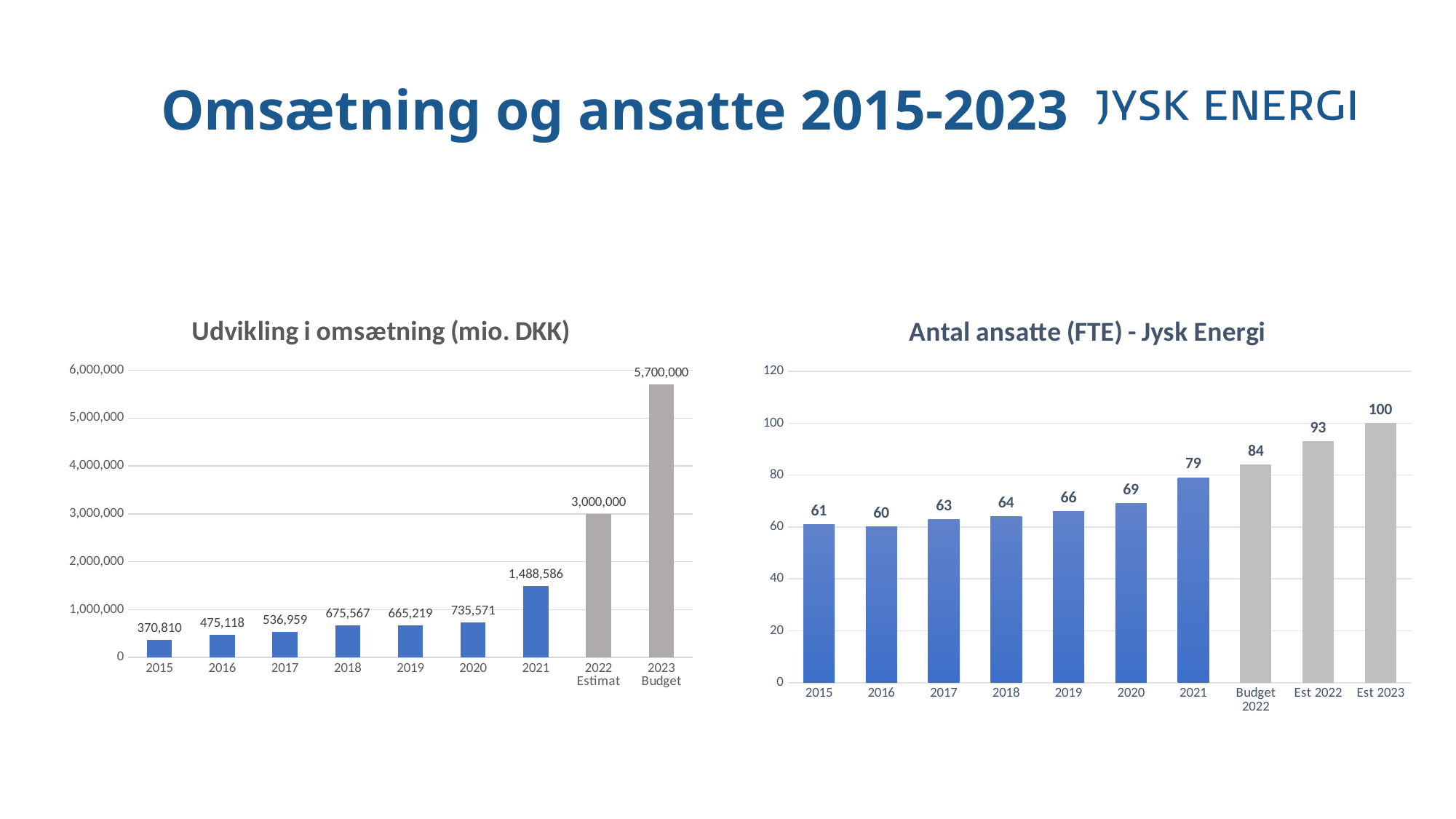
In the 'Antal ansatte (FTE) - Jysk Energi' chart, what is the value for 2019? 66 In the 'Udvikling i omsætning (mio. DKK)' chart, how many categories are shown on the x axis? 9 In the 'Antal ansatte (FTE) - Jysk Energi' chart, how many categories are shown on the x axis? 10 In the 'Udvikling i omsætning (mio. DKK)' chart, which category has the lowest value? 2015 What kind of chart is the 'Antal ansatte (FTE) - Jysk Energi' chart? Bar chart In the 'Udvikling i omsætning (mio. DKK)' chart, what is the value for 2023 Budget? 5,700,000 In the 'Antal ansatte (FTE) - Jysk Energi' chart, what is the difference between Est 2022 and Budget 2022? 9 In the 'Udvikling i omsætning (mio. DKK)' chart, what is the value for 2017? 536,959 In the 'Udvikling i omsætning (mio. DKK)' chart, which is larger, the value for 2018 or the value for 2019? 2018 In the 'Udvikling i omsætning (mio. DKK)' chart, what is the difference between the 2021 value and the 2020 value? 753,015 In the 'Antal ansatte (FTE) - Jysk Energi' chart, which category has the lowest value? 2016 In the 'Antal ansatte (FTE) - Jysk Energi' chart, which category has the highest value? Est 2023